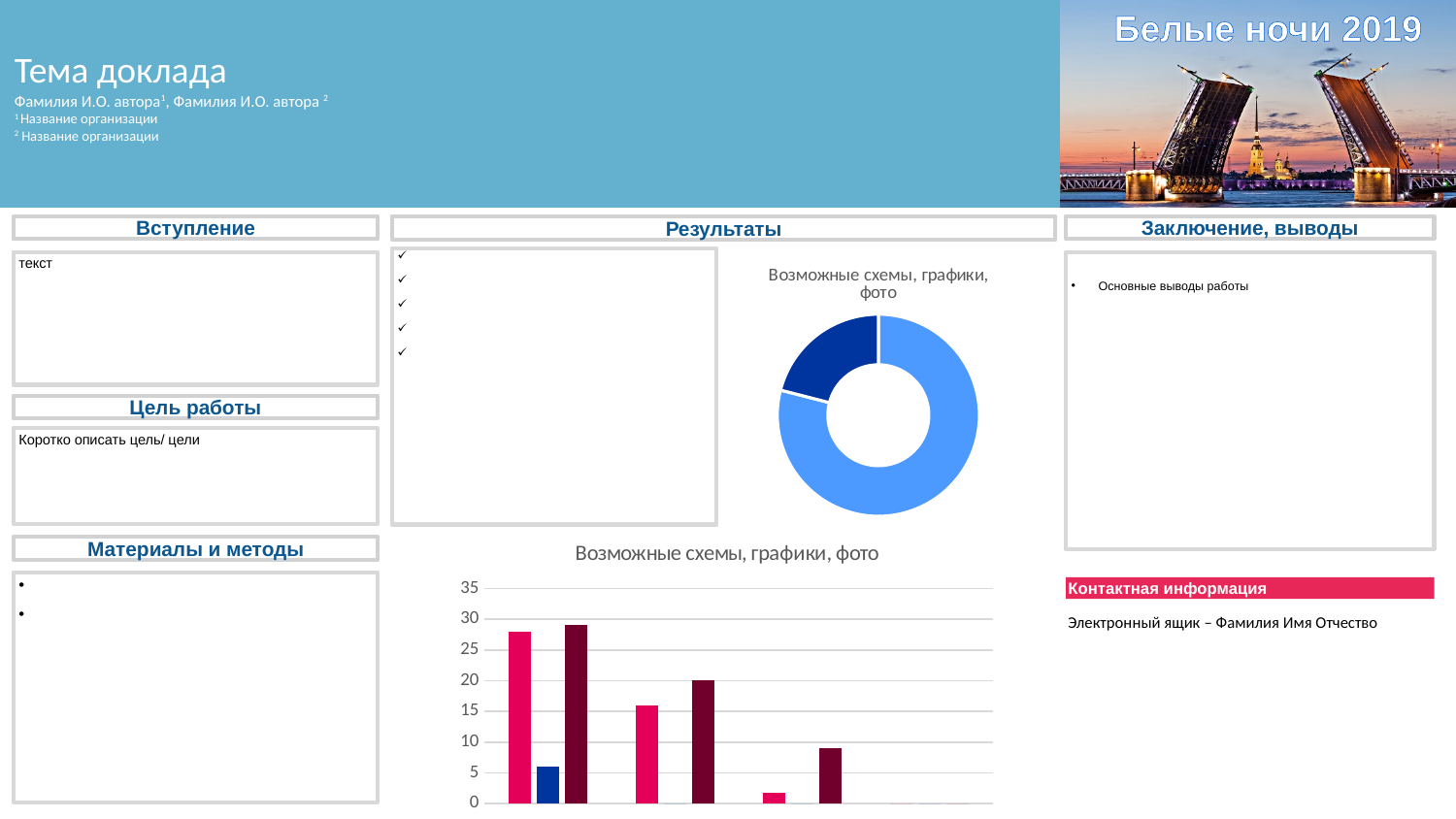
What is the title of the bar chart? Возможные схемы, графики, фото In the bar chart, is the value of the second bar from the left greater or less than 10? less In the bar chart, is the value of the tallest bar greater or less than 25? greater In the bar chart, is the value of the first (leftmost) bar greater or less than 25? greater What is the highest value shown on the y axis of the bar chart? 35 In the doughnut chart, which slice is larger, the light blue one or the dark blue one? the light blue one What kind of chart is the chart at the top right of the Результаты section? doughnut chart What kind of chart is the chart at the bottom of the Результаты section? bar chart In the bar chart, which is larger, the first bar from the left or the second bar from the left? the first bar In the doughnut chart, how many slices are shown? 2